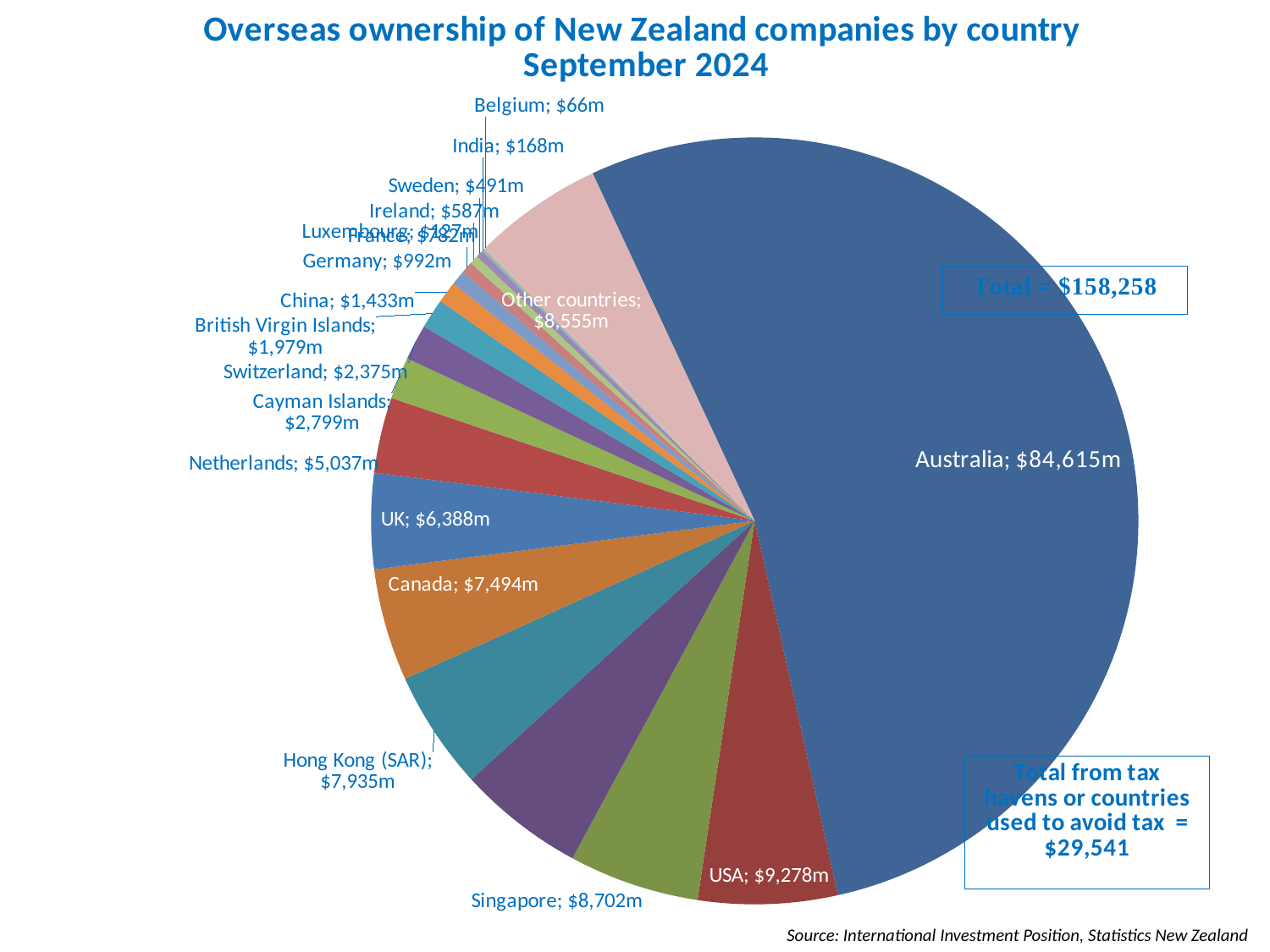
What is the value for the USA? $9,278m What is the value for Other countries? $8,555m What is the difference between the values for the USA and Singapore? $576m Which is larger, the value for Canada or the value for the UK? Canada What is the title of the chart? Overseas ownership of New Zealand companies by country September 2024 What is the value for Australia? $84,615m What is the value for Hong Kong (SAR)? $7,935m Which country has the largest slice of the pie? Australia Which labelled country has the smallest value? Belgium What is the value for the Cayman Islands? $2,799m What type of chart is shown on the slide? pie chart What total is shown in the box on the chart? $158,258